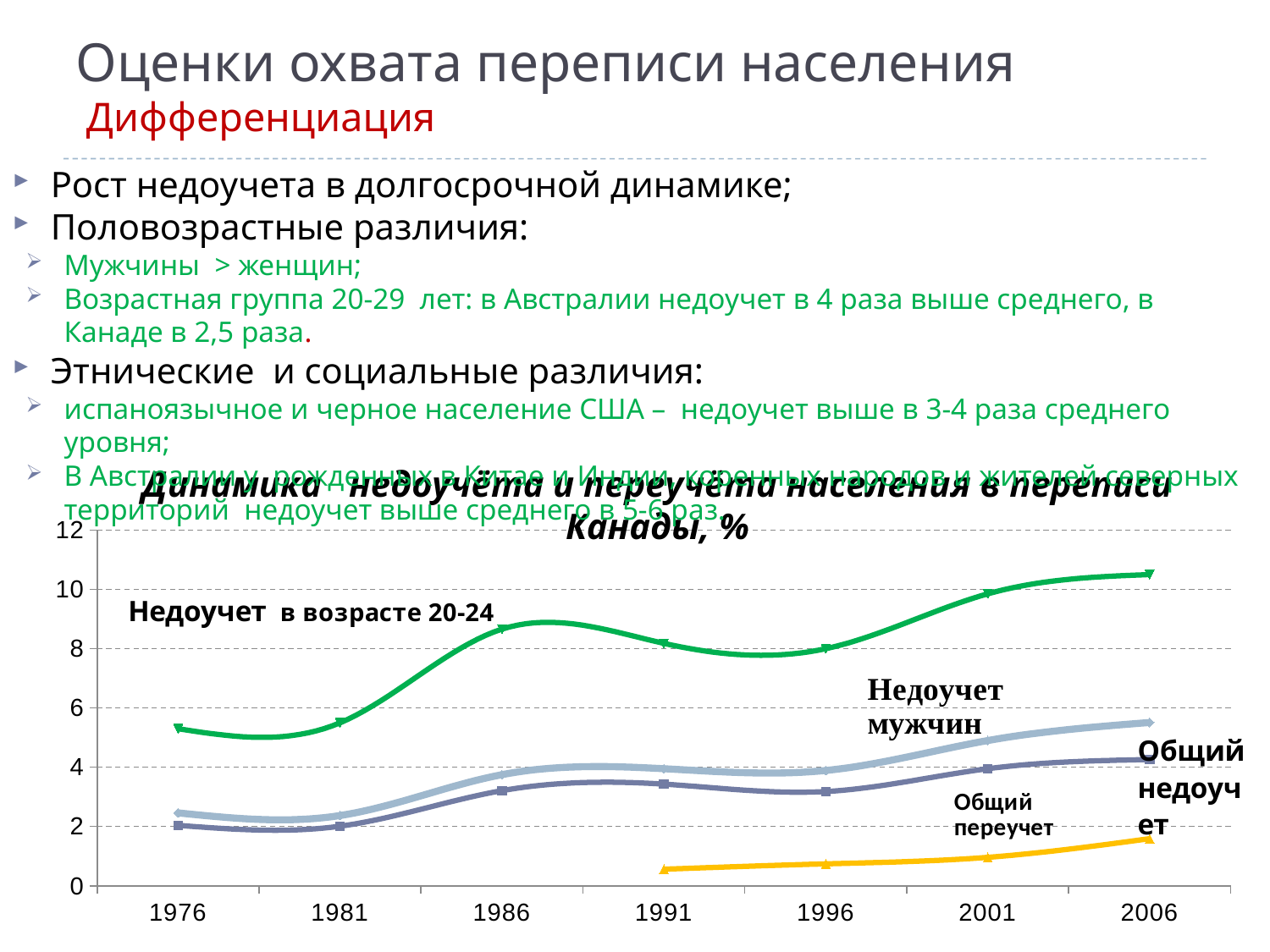
How many years are marked on the x axis of the chart? 7 In 2006, which is higher: 'Недоучет мужчин' or 'Общий недоучет'? Недоучет мужчин Is the value for 'Общий переучет' in 2006 greater or less than 2? less Is the value for 'Недоучет мужчин' in 2006 greater or less than 4? greater What is the title of the chart? Динамика недоучета и переучета населения в переписи Канады, % In which year does 'Недоучет в возрасте 20-24' reach its highest value? 2006 Which series has the lowest values on the chart? Общий переучет Is the value for 'Недоучет в возрасте 20-24' in 2006 greater or less than 10? greater How many lines (series) are plotted on the chart? 4 Does 'Общий переучет' rise or fall from 1991 to 2006? rises What kind of chart is shown on the slide? line chart